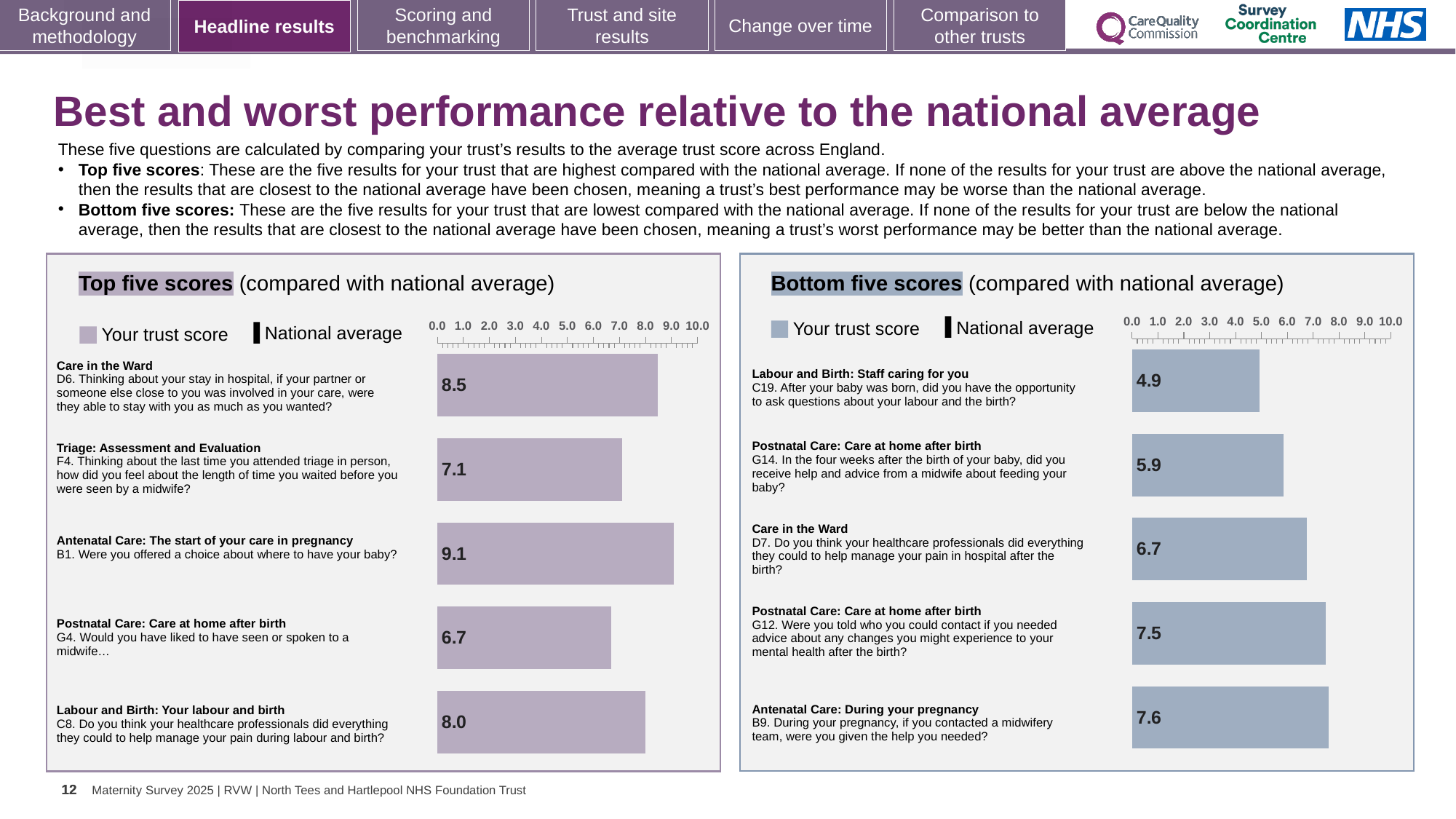
On the 'Bottom five scores' chart, what is the trust score for question C19 (Labour and Birth: Staff caring for you)? 4.9 On the 'Bottom five scores' chart, which question has the lowest trust score? C19 (Labour and Birth: Staff caring for you) What kind of chart is the 'Bottom five scores' chart? bar chart On the 'Top five scores' chart, what is the trust score for question D6 (Care in the Ward)? 8.5 On the 'Top five scores' chart, is the trust score for C8 greater or less than 5.0? greater On the 'Bottom five scores' chart, what is the trust score for question G14 (Postnatal Care: Care at home after birth)? 5.9 On the 'Top five scores' chart, which question has the highest trust score? B1 (Antenatal Care: The start of your care in pregnancy) How many bars are shown on the 'Top five scores' chart? 5 What two entries does the legend of the 'Top five scores' chart list? Your trust score, National average On the 'Top five scores' chart, what is the difference between the trust scores for B1 and G4? 2.4 On the 'Bottom five scores' chart, what is the difference between the trust scores for B9 and C19? 2.7 On the 'Bottom five scores' chart, which has the larger trust score: G12 or D7? G12